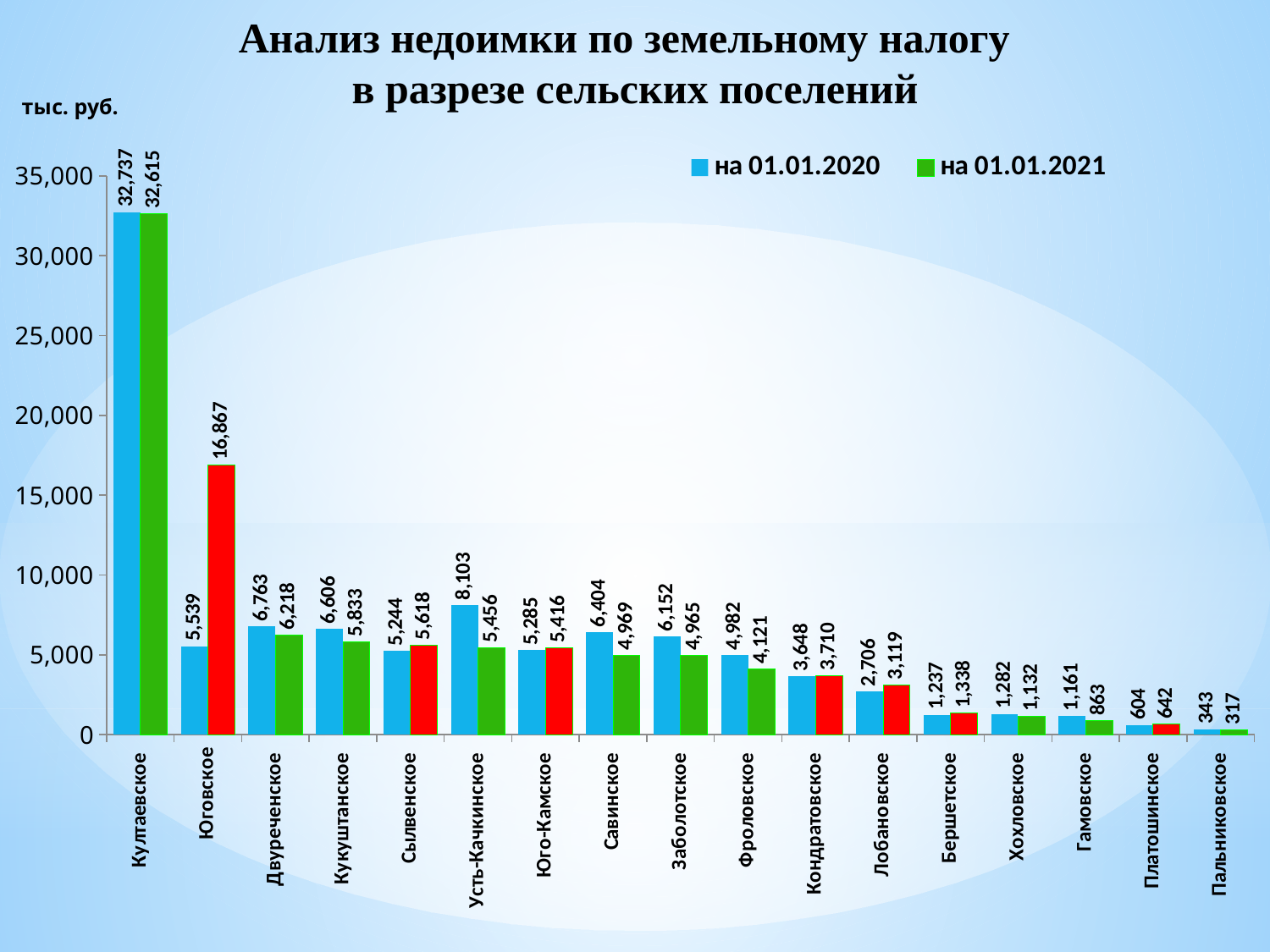
What is the difference between the на 01.01.2020 and на 01.01.2021 values for Култаевское? 122 Which category has the lowest value in the series на 01.01.2021? Пальниковское For Савинское, which series has the larger value: на 01.01.2020 or на 01.01.2021? на 01.01.2020 What unit is indicated in the top-left corner of the chart? тыс. руб. What is the difference between the на 01.01.2021 and на 01.01.2020 values for Юговское? 11,328 What is the value for Усть-Качкинское in the series на 01.01.2020? 8,103 How many series does the legend list? 2 What is the value for Юговское in the series на 01.01.2021? 16,867 What kind of chart is shown on the slide? bar chart What is the value for Гамовское in the series на 01.01.2021? 863 How many categories (settlements) are shown on the x axis? 17 Which category has the highest value in the series на 01.01.2020? Култаевское